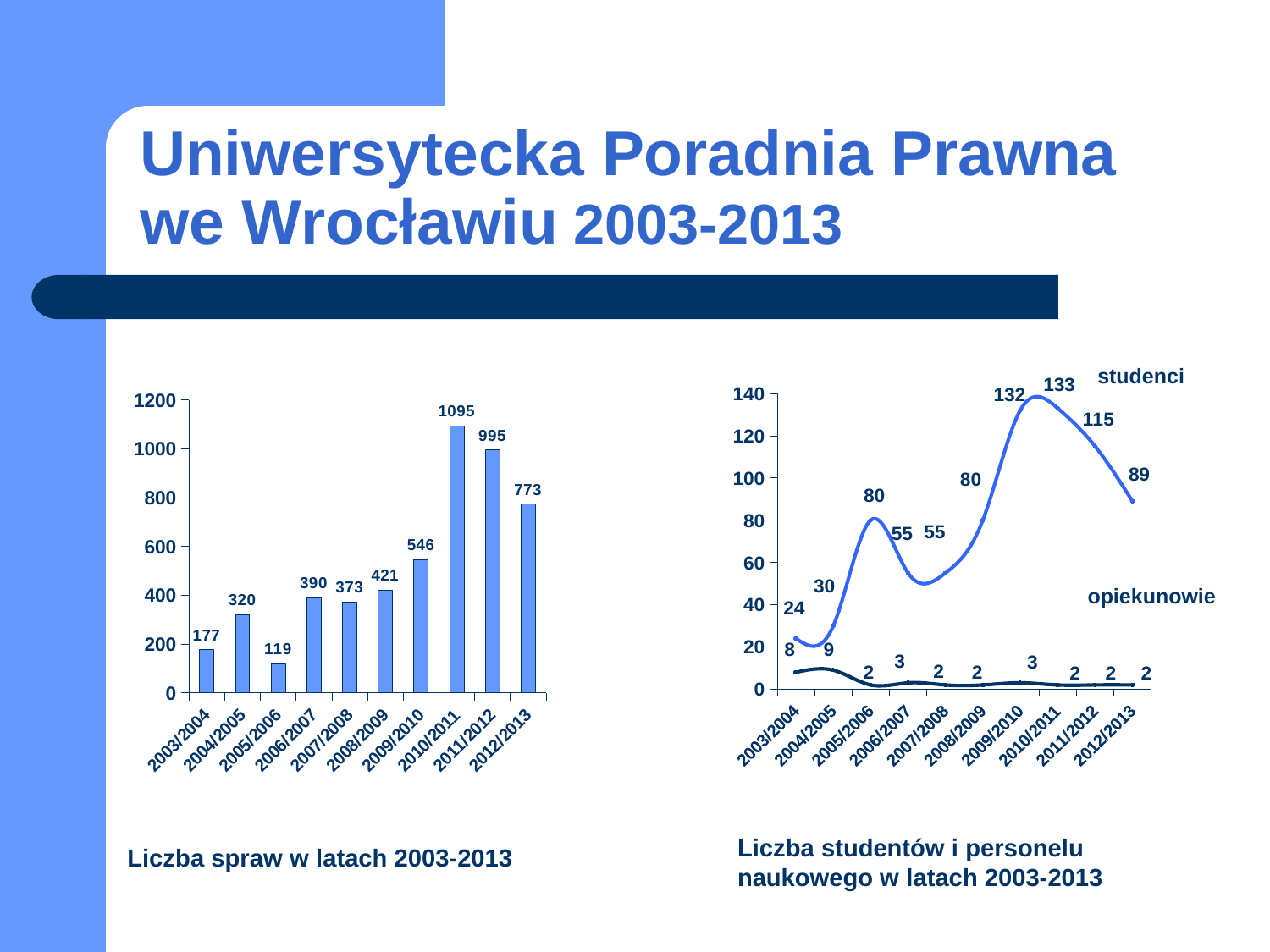
In the left chart (Liczba spraw w latach 2003-2013), how many years are shown on the x axis? 10 In the right chart (Liczba studentów i personelu naukowego), what is the value for opiekunowie in 2003/2004? 8 In the right chart (Liczba studentów i personelu naukowego), how many series are plotted? 2 What kind of chart is the left chart (Liczba spraw w latach 2003-2013)? bar chart In the left chart (Liczba spraw w latach 2003-2013), which year has the highest value? 2010/2011 In the left chart (Liczba spraw w latach 2003-2013), which year has the lowest value? 2005/2006 In the left chart (Liczba spraw w latach 2003-2013), what is the value for 2010/2011? 1095 In the right chart (Liczba studentów i personelu naukowego), what is the value for studenci in 2009/2010? 132 In the right chart (Liczba studentów i personelu naukowego), in which year does the studenci series reach its highest value? 2010/2011 In the right chart (Liczba studentów i personelu naukowego), does the studenci series rise or fall from 2010/2011 to 2012/2013? fall In the left chart (Liczba spraw w latach 2003-2013), what is the difference between the values for 2011/2012 and 2012/2013? 222 In the right chart (Liczba studentów i personelu naukowego), what is the difference between studenci and opiekunowie in 2012/2013? 87